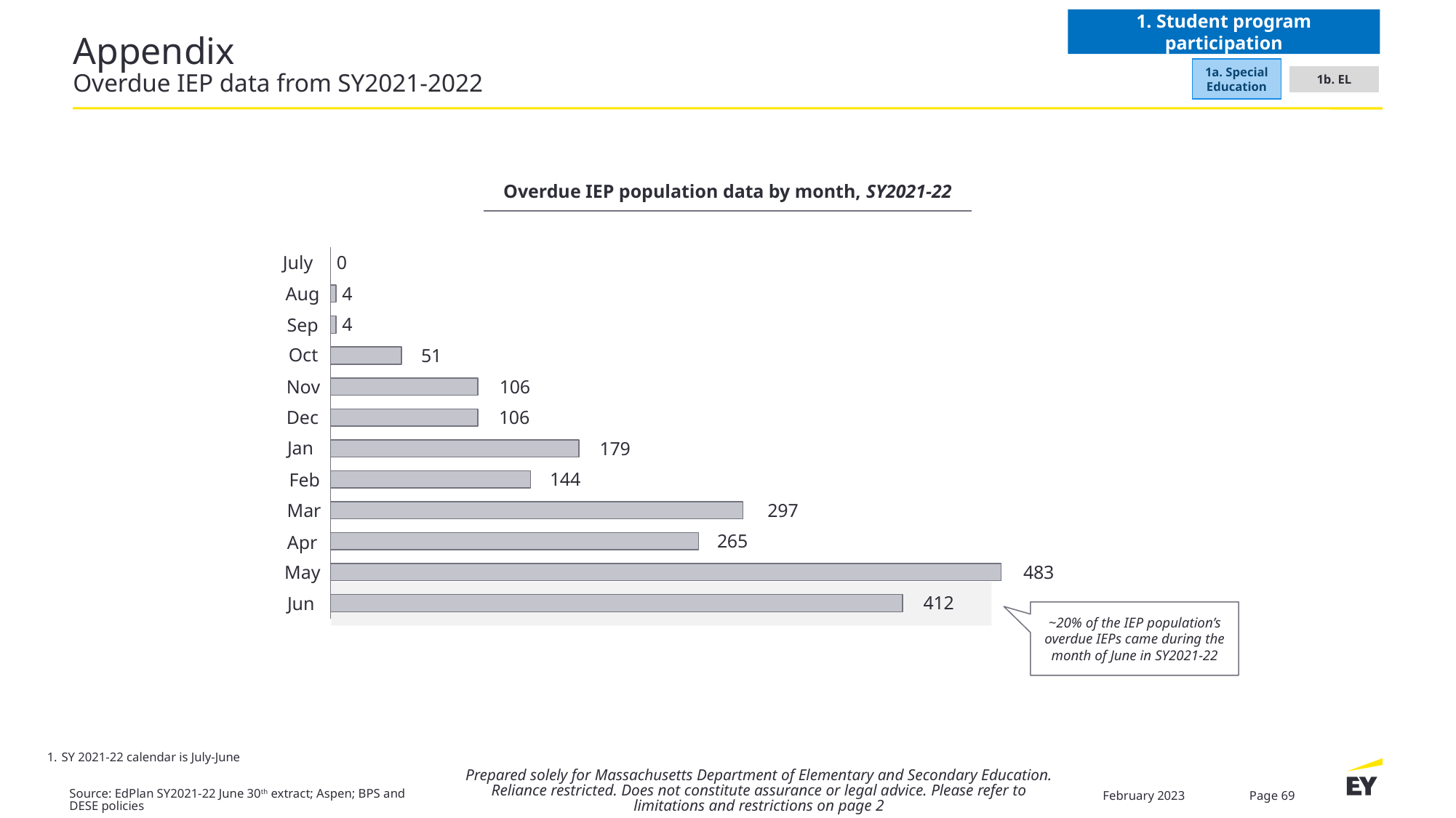
What is the difference between the values for Mar and Apr? 32 Which is larger, the value for Jan or the value for Feb? Jan What is the overdue IEP value for Jan? 179 What is the overdue IEP value for Oct? 51 Which month has the highest overdue IEP value? May What kind of chart is shown on the slide? Bar chart What is the overdue IEP value for Aug? 4 Which month has the lowest overdue IEP value? July What is the title of the chart? Overdue IEP population data by month, SY2021-22 How many months are shown in the chart? 12 What is the difference between the values for May and Jun? 71 What is the overdue IEP value for May? 483